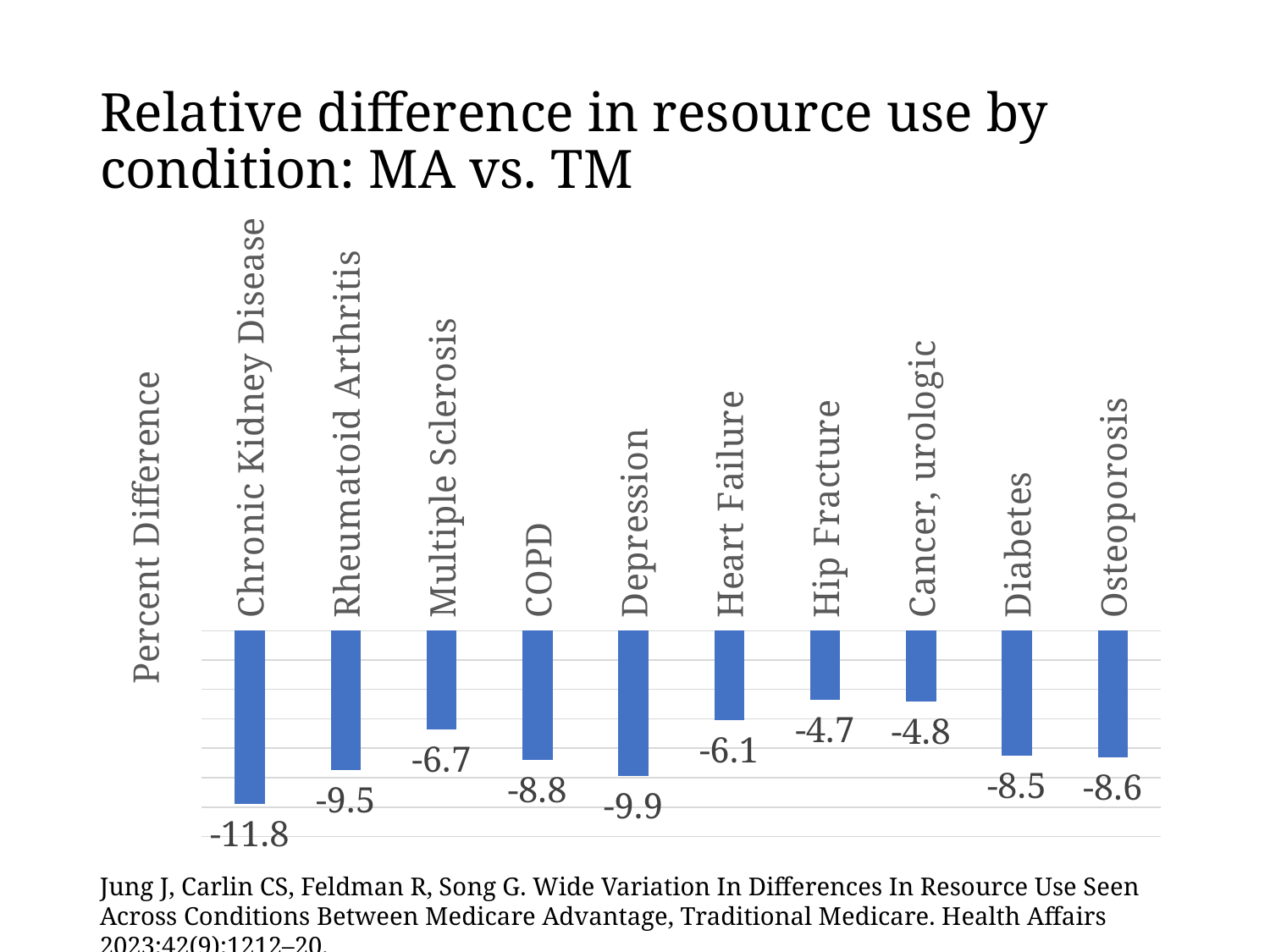
What is the value for Chronic Kidney Disease? -11.8 How many conditions are shown in the chart? 10 Which condition has the lowest (most negative) value? Chronic Kidney Disease What is the value for Osteoporosis? -8.6 Which has the more negative value, Depression or COPD? Depression What is the value for Hip Fracture? -4.7 What kind of chart is shown on the slide? Bar chart What is the label on the vertical axis of the chart? Percent Difference What is the difference between the values for Chronic Kidney Disease and Hip Fracture? 7.1 What is the difference between the values for Depression and Rheumatoid Arthritis? 0.4 Which condition has the highest (least negative) value? Hip Fracture What is the value for Depression? -9.9